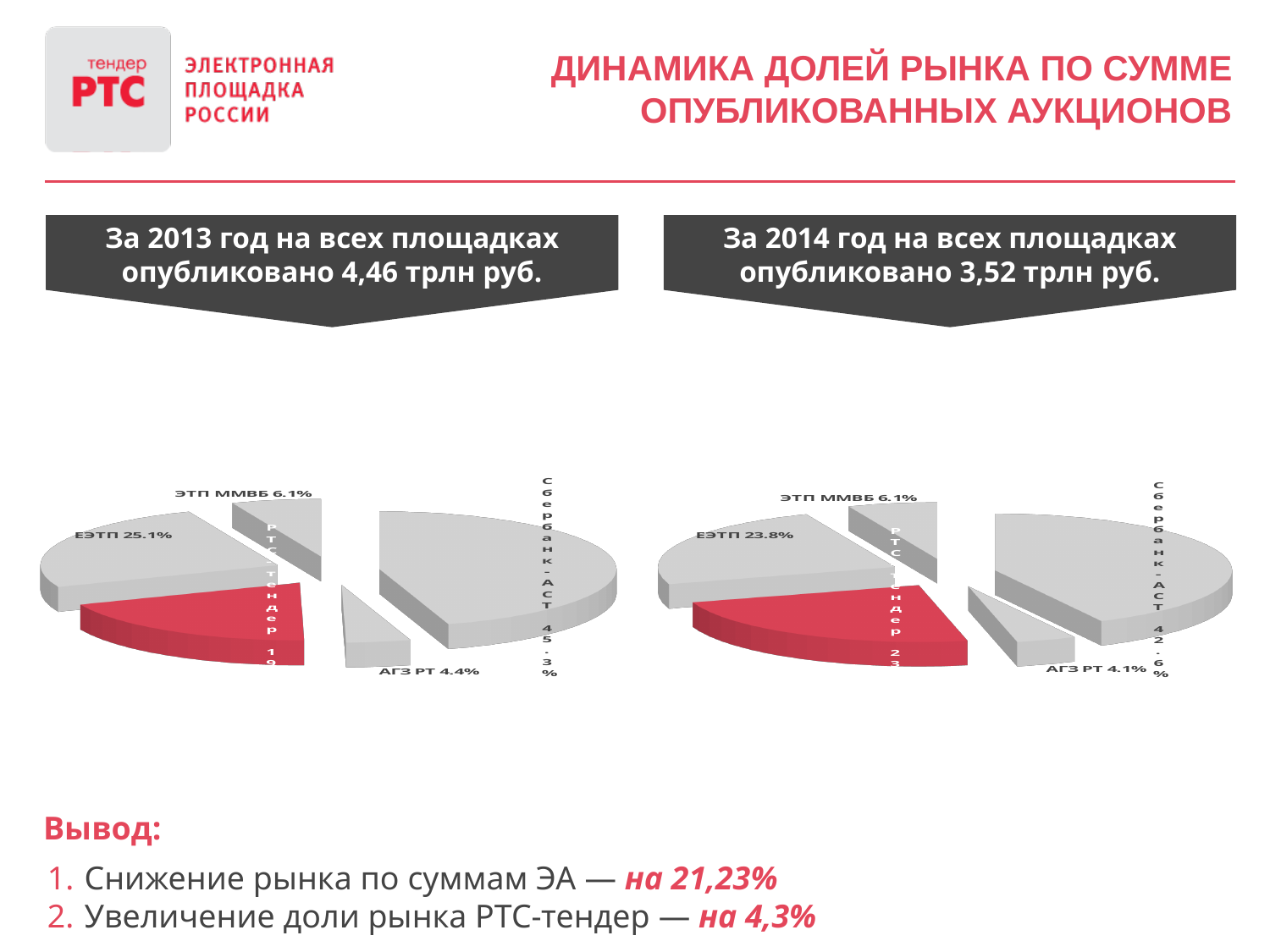
In the left pie chart (2013), what share is shown for ЭТП ММВБ? 6.1% In the left pie chart (2013), what share is shown for ЕЭТП? 25.1% In the right pie chart (2014), which platform has the smallest share? АГЗ РТ What type of chart is used on this slide? Pie chart Which is larger: the share of ЕЭТП in the 2013 chart or in the 2014 chart? 2013 (25.1%) How many slices does the left pie chart (2013) have? 5 In the right pie chart (2014), what share is shown for Сбербанк-АСТ? 42.6% In the left pie chart (2013), which platform has the largest share? Сбербанк-АСТ In the right pie chart (2014), what share is shown for АГЗ РТ? 4.1% In the right pie chart (2014), what share is shown for ЕЭТП? 23.8% By how many percentage points did the share of Сбербанк-АСТ change from the 2013 chart (45.3%) to the 2014 chart (42.6%)? 2.7 percentage points lower In the left pie chart (2013), what share is shown for Сбербанк-АСТ? 45.3%